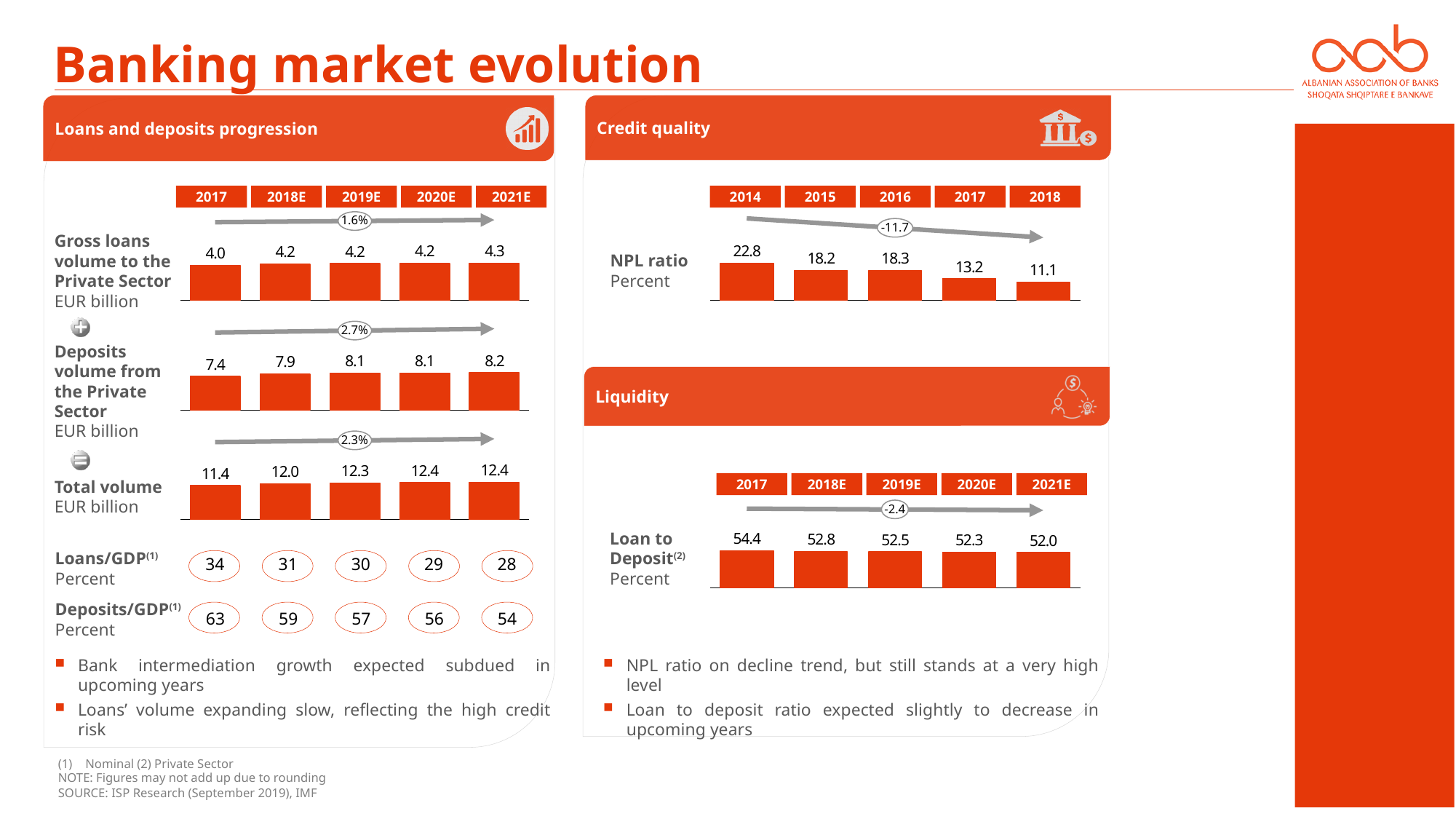
In the Loan to Deposit chart, which is larger, the value for 2017 or the value for 2021E? 2017 In the NPL ratio chart, do the values generally rise or fall from 2014 to 2018? fall How many years are shown on the x axis of the Loan to Deposit chart? 5 In the NPL ratio chart, which year has the highest value? 2014 What kind of chart is the Gross loans volume to the Private Sector chart? bar chart In the Total volume chart, which year has the lowest value? 2017 In the NPL ratio chart, what is the value for 2018? 11.1 In the Gross loans volume to the Private Sector chart, what is the value for 2021E? 4.3 In the Deposits volume from the Private Sector chart, what is the value for 2017? 7.4 In the Total volume chart, what is the difference between the 2021E value and the 2017 value? 1.0 In the NPL ratio chart, what is the difference between the 2014 value and the 2018 value? 11.7 In the Loan to Deposit chart, what is the value for 2019E? 52.5